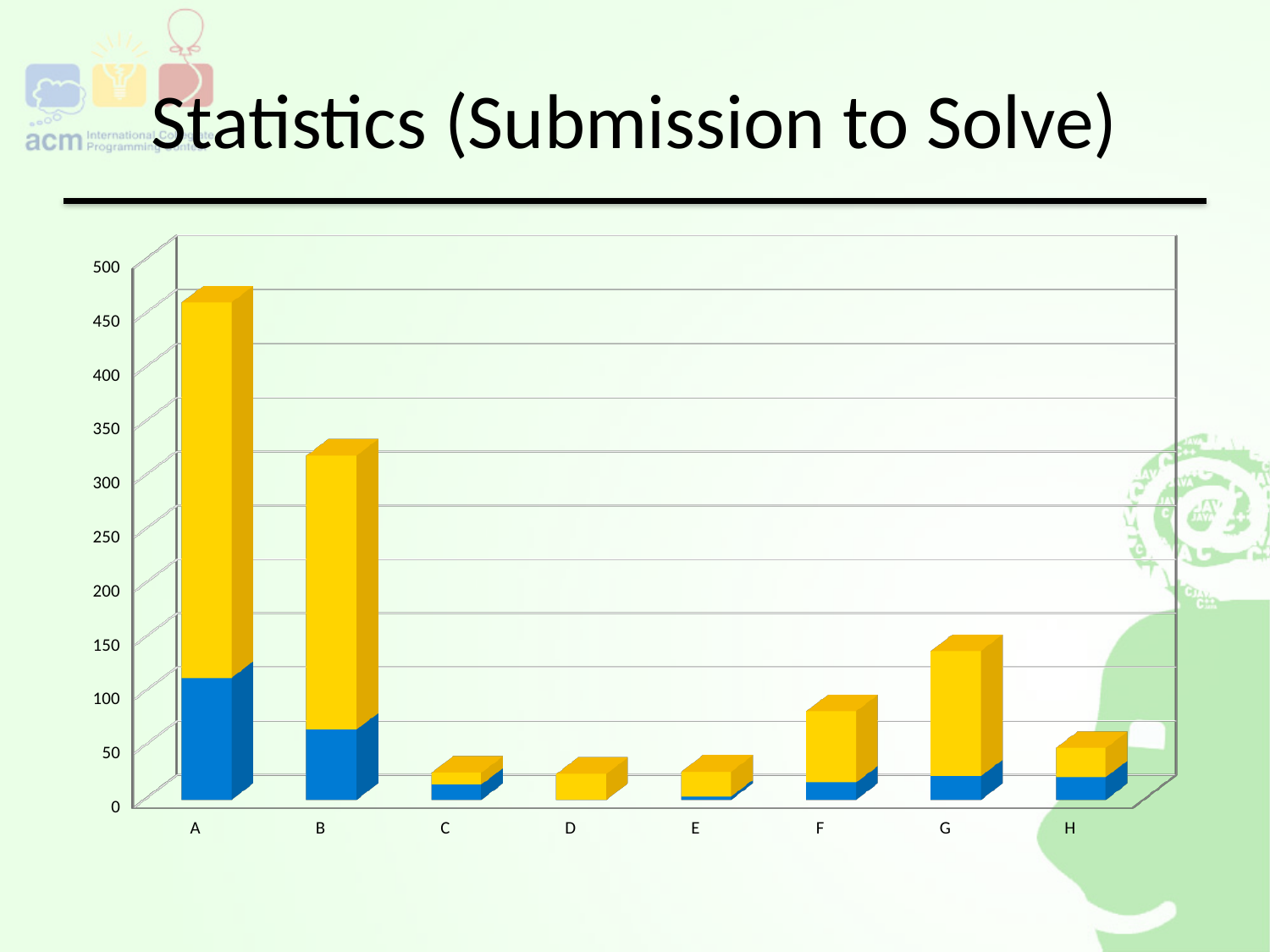
Which bar is taller, the one for category B or the one for category G? B Is the total bar for category G greater or less than 100? greater Which category has the tallest bar in the chart? A Which bar is taller, the one for category F or the one for category H? F Is the total bar for category C greater or less than 50? less How many differently coloured segments are stacked in each bar of the chart? 2 Is the total bar for category A greater or less than 400? greater What is the title of the slide containing the chart? Statistics (Submission to Solve) How many categories are shown along the x axis of the chart? 8 What kind of chart is shown on the slide? Stacked bar chart